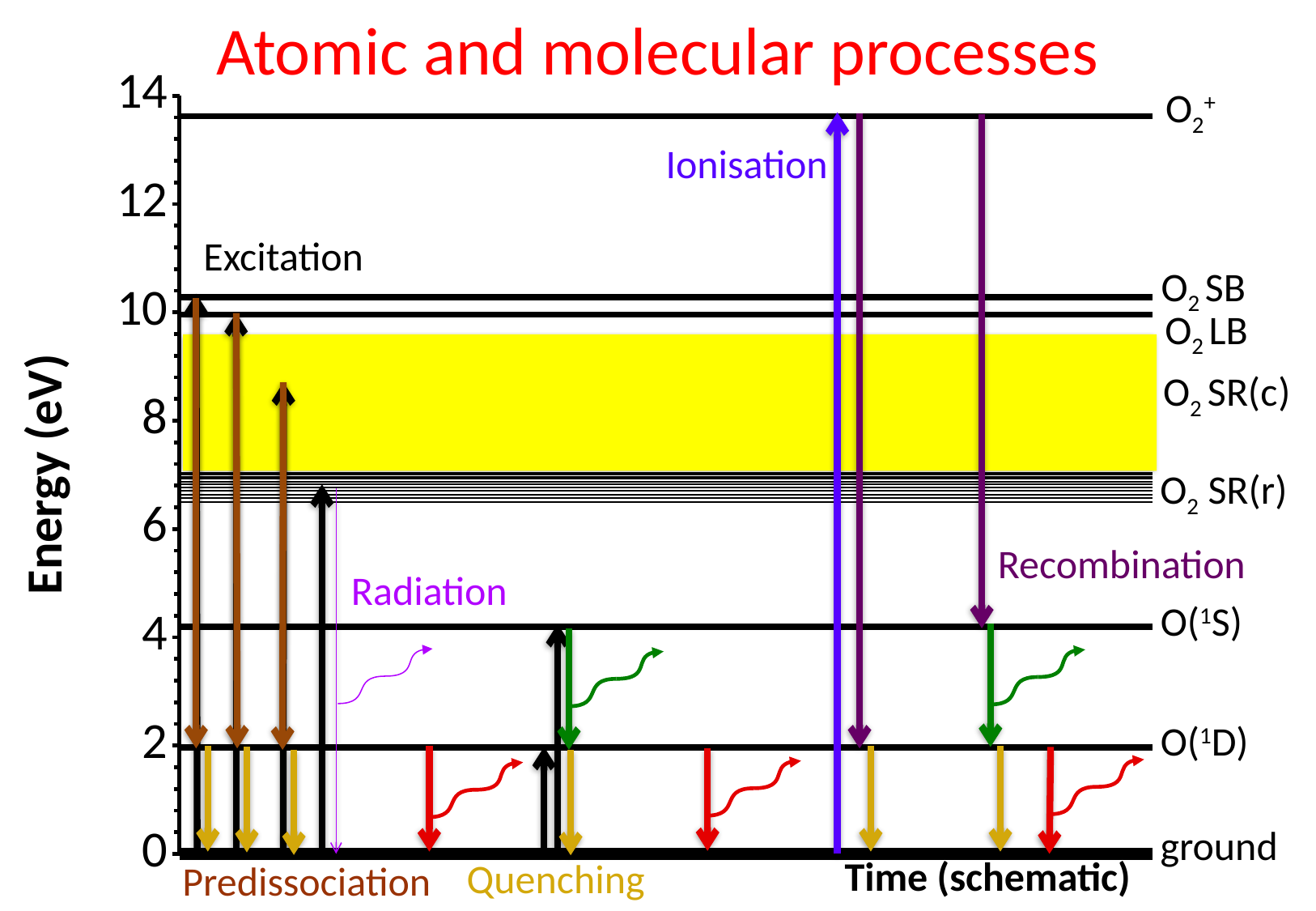
Which labelled energy level is the highest on the diagram? O2+ Is the energy of the O(1D) level greater or less than 4 eV? less Which level has higher energy, O2 SB or O2 SR(r)? O2 SB Is the energy of the O2+ level greater or less than 12 eV? greater Which level has higher energy, O(1S) or O(1D)? O(1S) What is the energy value of the ground level on the axis? 0 Is the energy of the O2 SR(r) level greater or less than 8 eV? less What is the title of the diagram on the slide? Atomic and molecular processes Which labelled energy level is the lowest on the diagram? ground What is the label of the vertical axis? Energy (eV)